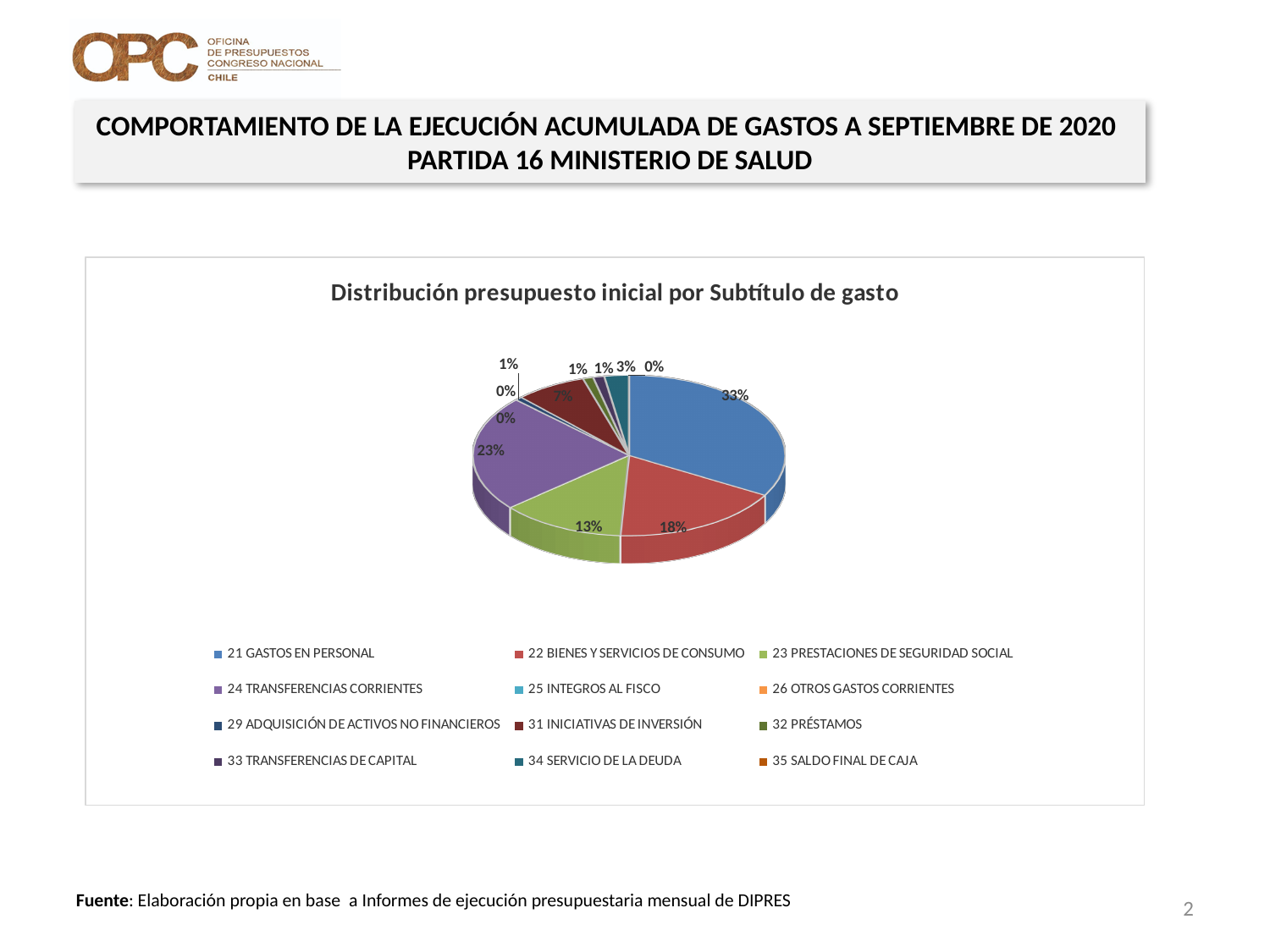
What share of the pie does 22 BIENES Y SERVICIOS DE CONSUMO represent? 18% What is the difference in percentage points between the slice for 24 TRANSFERENCIAS CORRIENTES and the slice for 23 PRESTACIONES DE SEGURIDAD SOCIAL? 10 percentage points What is the difference in percentage points between the slice for 21 GASTOS EN PERSONAL and the slice for 24 TRANSFERENCIAS CORRIENTES? 10 percentage points Which is larger, the slice for 22 BIENES Y SERVICIOS DE CONSUMO or the slice for 23 PRESTACIONES DE SEGURIDAD SOCIAL? 22 BIENES Y SERVICIOS DE CONSUMO Which category has the largest slice of the pie? 21 GASTOS EN PERSONAL What kind of chart is shown on the slide? pie chart How many categories does the legend list? 12 What share of the pie does 31 INICIATIVAS DE INVERSIÓN represent? 7% What is the title of the chart? Distribución presupuesto inicial por Subtítulo de gasto What share of the pie does 24 TRANSFERENCIAS CORRIENTES represent? 23%